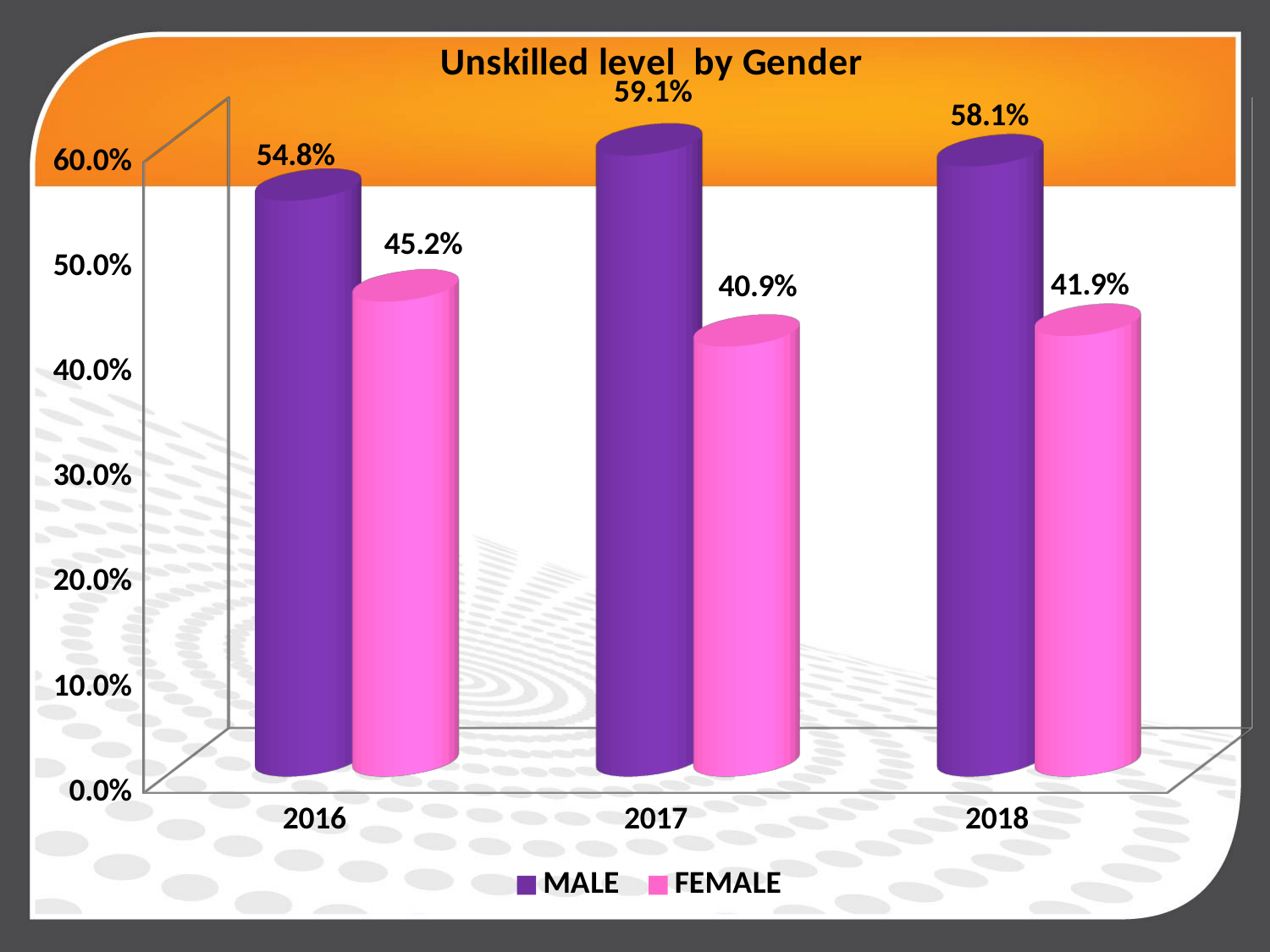
What is the FEMALE value for 2018? 41.9% What is the MALE value for 2017? 59.1% In which year is the MALE value highest? 2017 What kind of chart is shown? bar chart What is the title of the chart? Unskilled level by Gender In which year is the FEMALE value lowest? 2017 What is the difference between the MALE and FEMALE values in 2016? 9.6% Is the MALE value for 2016 greater or less than 50.0%? greater How many series does the legend list? 2 Which is larger in 2018, the MALE value or the FEMALE value? MALE How many years are shown on the x axis? 3 What is the FEMALE value for 2016? 45.2%